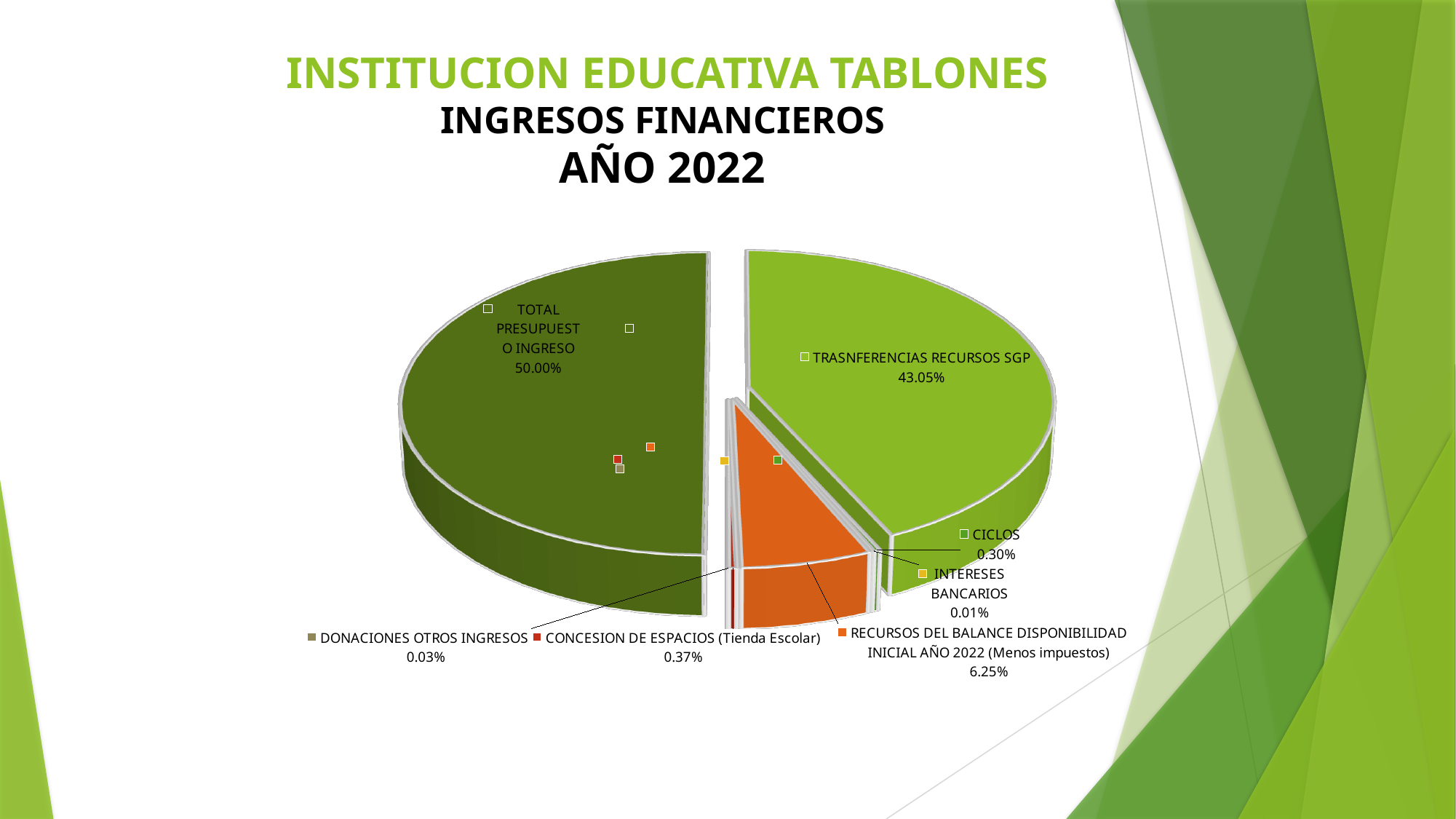
What percentage is shown for RECURSOS DEL BALANCE DISPONIBILIDAD INICIAL AÑO 2022 (Menos impuestos)? 6.25% What percentage is shown for TRASNFERENCIAS RECURSOS SGP? 43.05% Which labeled slice has the largest share of the pie? TOTAL PRESUPUESTO INGRESO What kind of chart is shown on the slide? pie chart Which is larger, the share for CICLOS or the share for CONCESION DE ESPACIOS (Tienda Escolar)? CONCESION DE ESPACIOS (Tienda Escolar) What percentage is shown for CICLOS? 0.30% What percentage is shown for CONCESION DE ESPACIOS (Tienda Escolar)? 0.37% What percentage is shown for TOTAL PRESUPUESTO INGRESO? 50.00% Which labeled slice has the smallest share of the pie? INTERESES BANCARIOS What is the difference in percentage points between TOTAL PRESUPUESTO INGRESO and TRASNFERENCIAS RECURSOS SGP? 6.95 What percentage is shown for DONACIONES OTROS INGRESOS? 0.03% What percentage is shown for INTERESES BANCARIOS? 0.01%